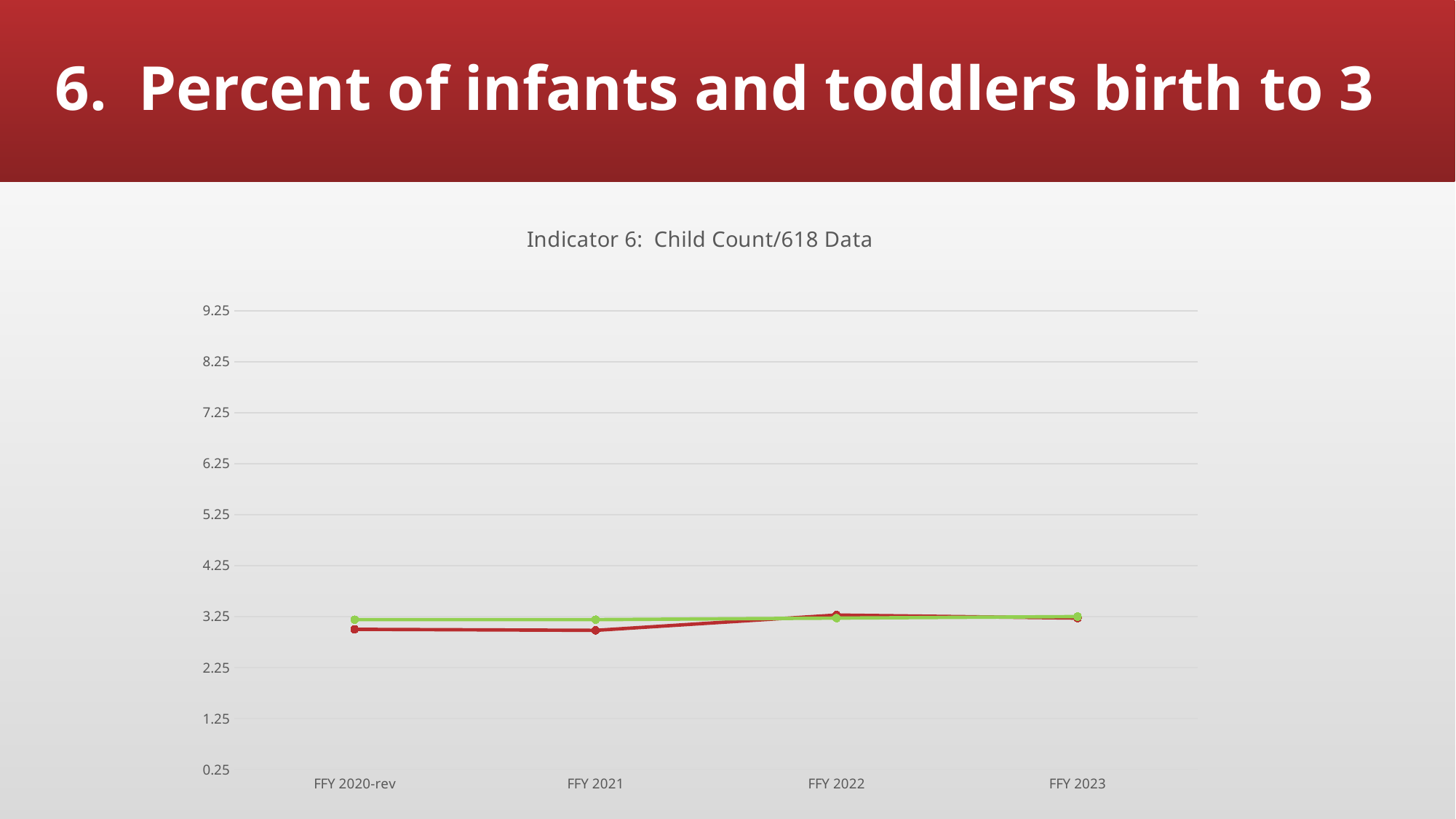
How many lines (series) are plotted on the chart? 2 What kind of chart is shown on the slide? line chart Is the value of the green line for FFY 2023 greater or less than 2.25? greater Is the value of the red line for FFY 2020-rev greater or less than 3.25? less Is the value of the red line for FFY 2022 greater or less than 4.25? less At FFY 2020-rev, which line has the higher value, the red line or the green line? green line What is the highest tick value shown on the y axis? 9.25 How many FFY categories are shown on the x axis? 4 What is the title of the chart? Indicator 6: Child Count/618 Data At FFY 2021, which line has the higher value, the red line or the green line? green line Does the red line rise or fall from FFY 2021 to FFY 2022? rise